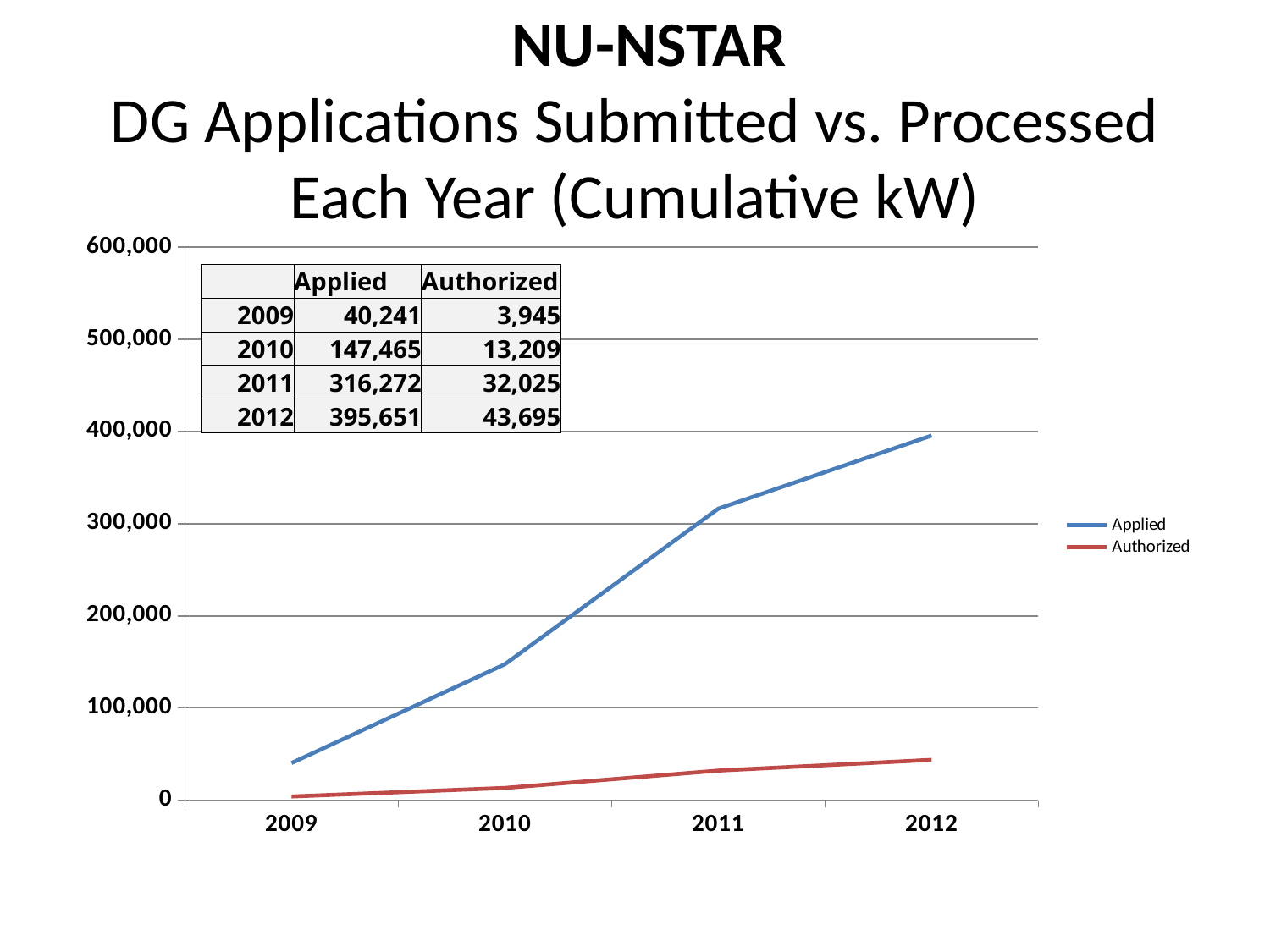
What is the difference between the Applied and Authorized values in 2012? 351,956 In which year is the Applied value highest? 2012 In which year is the Authorized value lowest? 2009 Does the Applied series rise or fall from 2009 to 2012? rise What is the Authorized value for 2011? 32,025 How many series does the legend list? 2 Which colour is used for the Authorized line? red How many years are plotted on the x axis? 4 What type of chart is shown on the slide? line chart What is the Applied value for 2012? 395,651 What is the Applied value for 2010? 147,465 Which is larger in 2011, the Applied value or the Authorized value? Applied